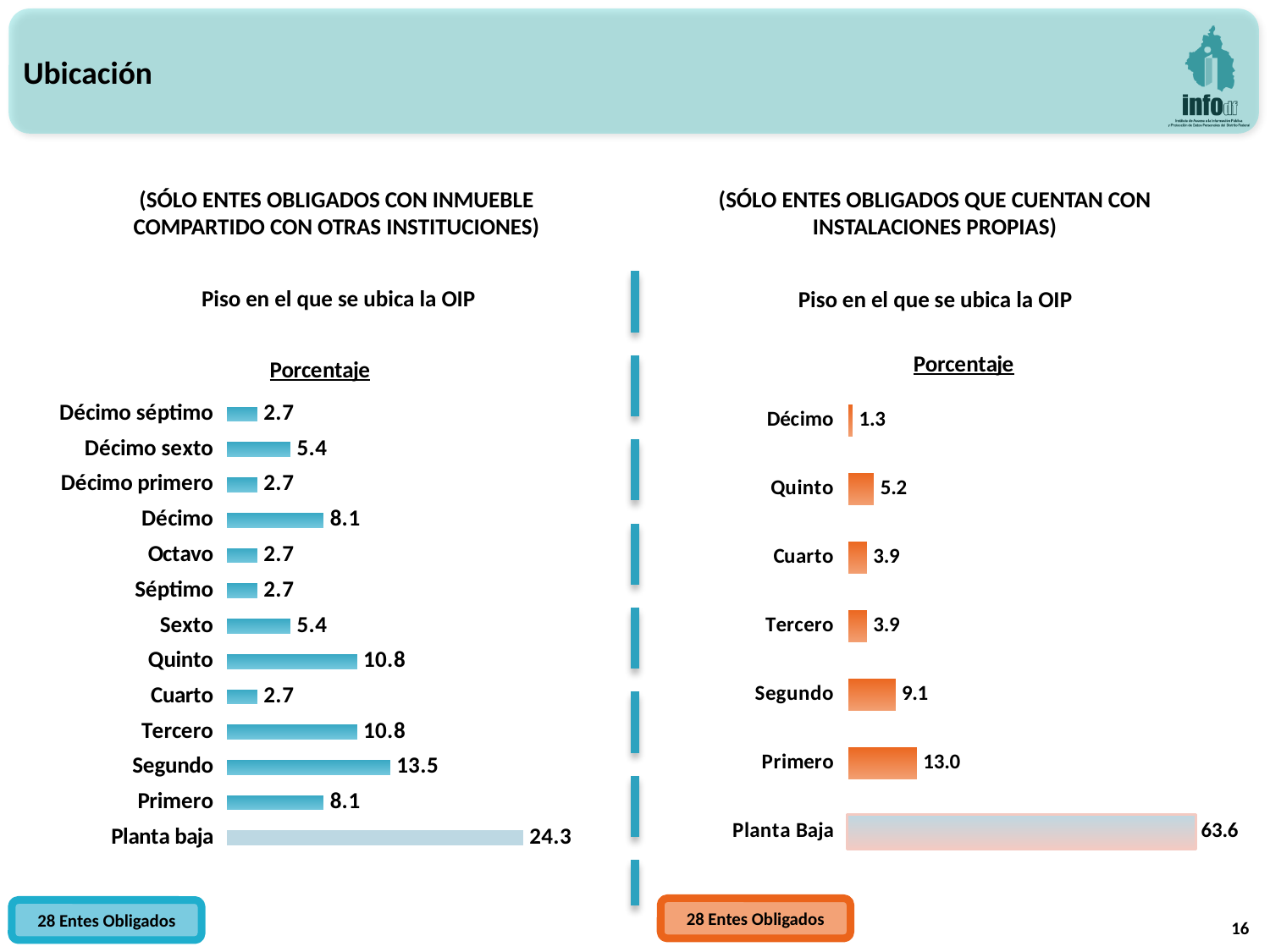
How many categories are shown in the right chart (instalaciones propias)? 7 In the right chart (instalaciones propias), what is the value for Primero? 13.0 What type of chart is the right chart (instalaciones propias)? Bar chart In the left chart (inmueble compartido), what is the difference between Planta baja and Segundo? 10.8 In the right chart (instalaciones propias), which category has the highest value? Planta Baja In the right chart (instalaciones propias), what is the difference between Planta Baja and Primero? 50.6 In the right chart (instalaciones propias), which category has the lowest value? Décimo In the left chart (inmueble compartido), which category has the highest value? Planta baja How many categories are shown in the left chart (inmueble compartido)? 13 In the left chart (inmueble compartido), what is the value for Planta baja? 24.3 In the left chart (inmueble compartido), what is the value for Segundo? 13.5 In the left chart (inmueble compartido), which is larger, Quinto or Décimo? Quinto